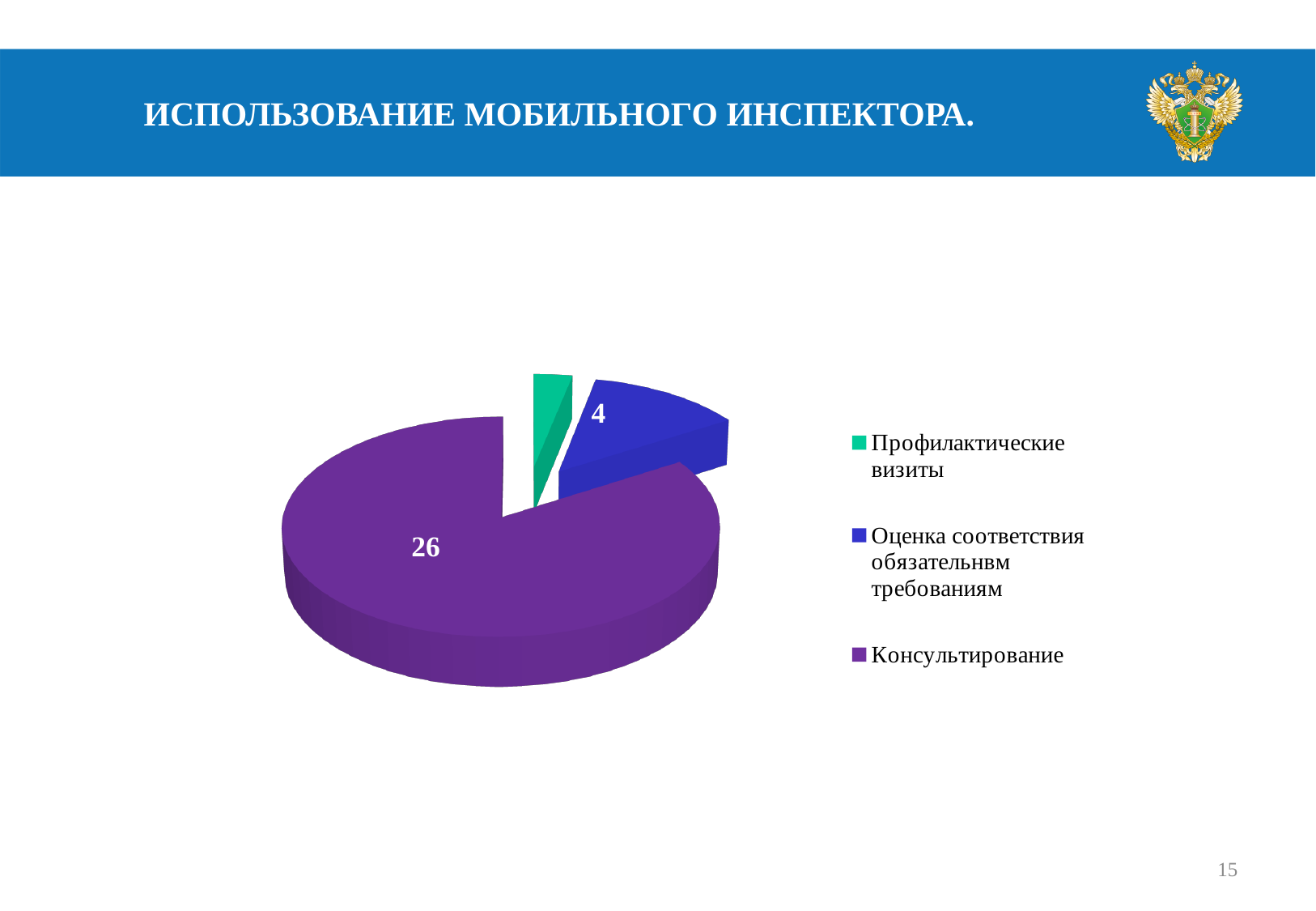
What is the title of the slide containing the chart? ИСПОЛЬЗОВАНИЕ МОБИЛЬНОГО ИНСПЕКТОРА. Which category has the largest slice of the pie? Консультирование What is the difference between the values for Консультирование and Оценка соответствия обязательнвм требованиям? 22 How many categories does the pie chart have? 3 Which slice is larger, Профилактические визиты or Оценка соответствия обязательнвм требованиям? Оценка соответствия обязательнвм требованиям Which is larger, Консультирование or Оценка соответствия обязательнвм требованиям? Консультирование What kind of chart is shown on the slide? pie chart What is the value for Оценка соответствия обязательнвм требованиям? 4 How many entries does the legend list? 3 What colour is the Консультирование slice? purple What is the value for Консультирование? 26 Which category has the smallest slice of the pie? Профилактические визиты